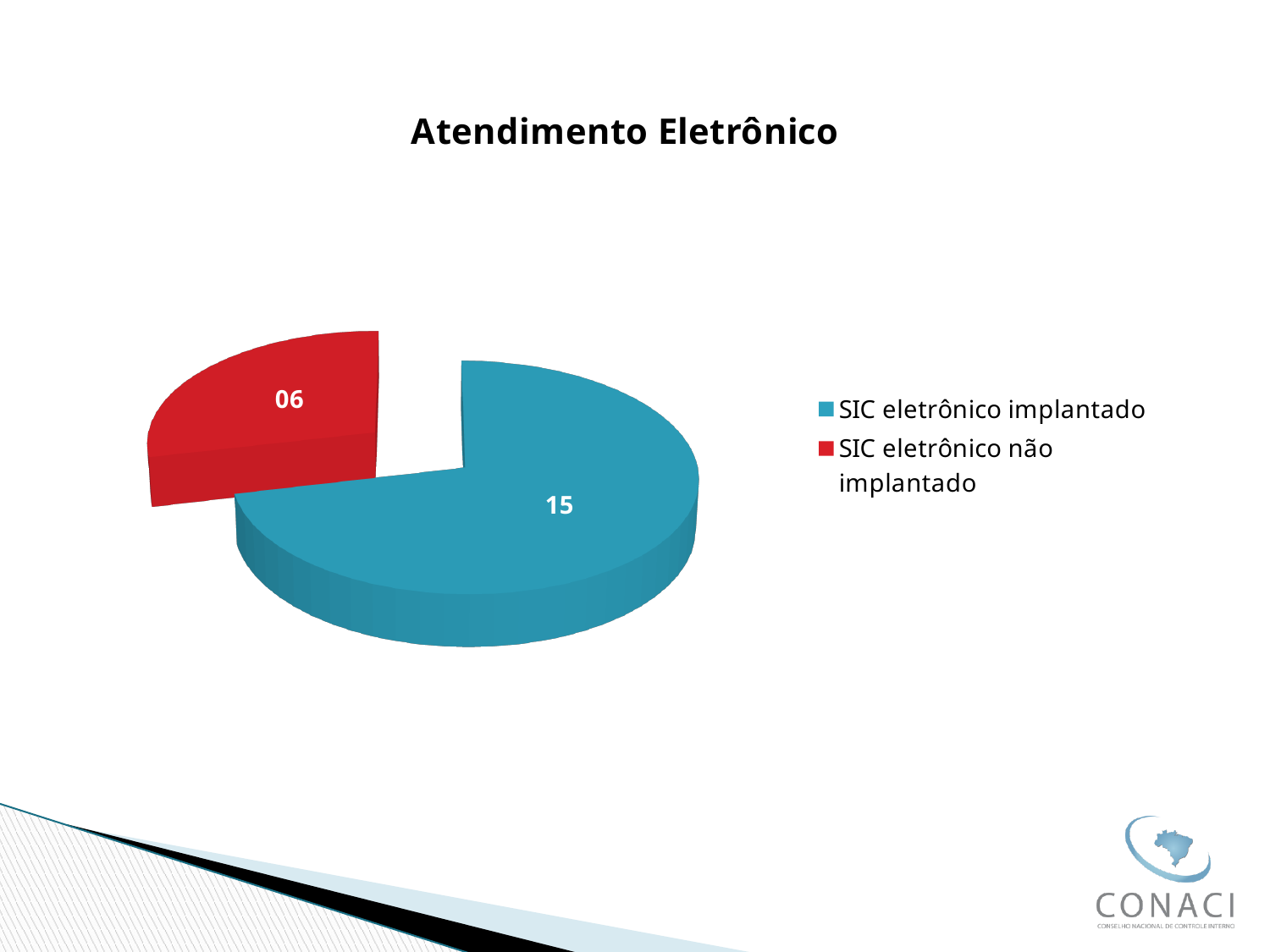
Which category has the largest slice of the pie? SIC eletrônico implantado What is the title of the chart? Atendimento Eletrônico How many entries does the legend list? 2 What colour is the slice for SIC eletrônico não implantado? red What is the total of all slices in the pie chart? 21 What is the value for SIC eletrônico não implantado? 06 What is the value for SIC eletrônico implantado? 15 Which category has the smallest slice of the pie? SIC eletrônico não implantado What type of chart is shown on the slide? pie chart What is the difference between the values for SIC eletrônico implantado and SIC eletrônico não implantado? 9 How many categories does the pie chart have? 2 Which is larger: SIC eletrônico implantado or SIC eletrônico não implantado? SIC eletrônico implantado